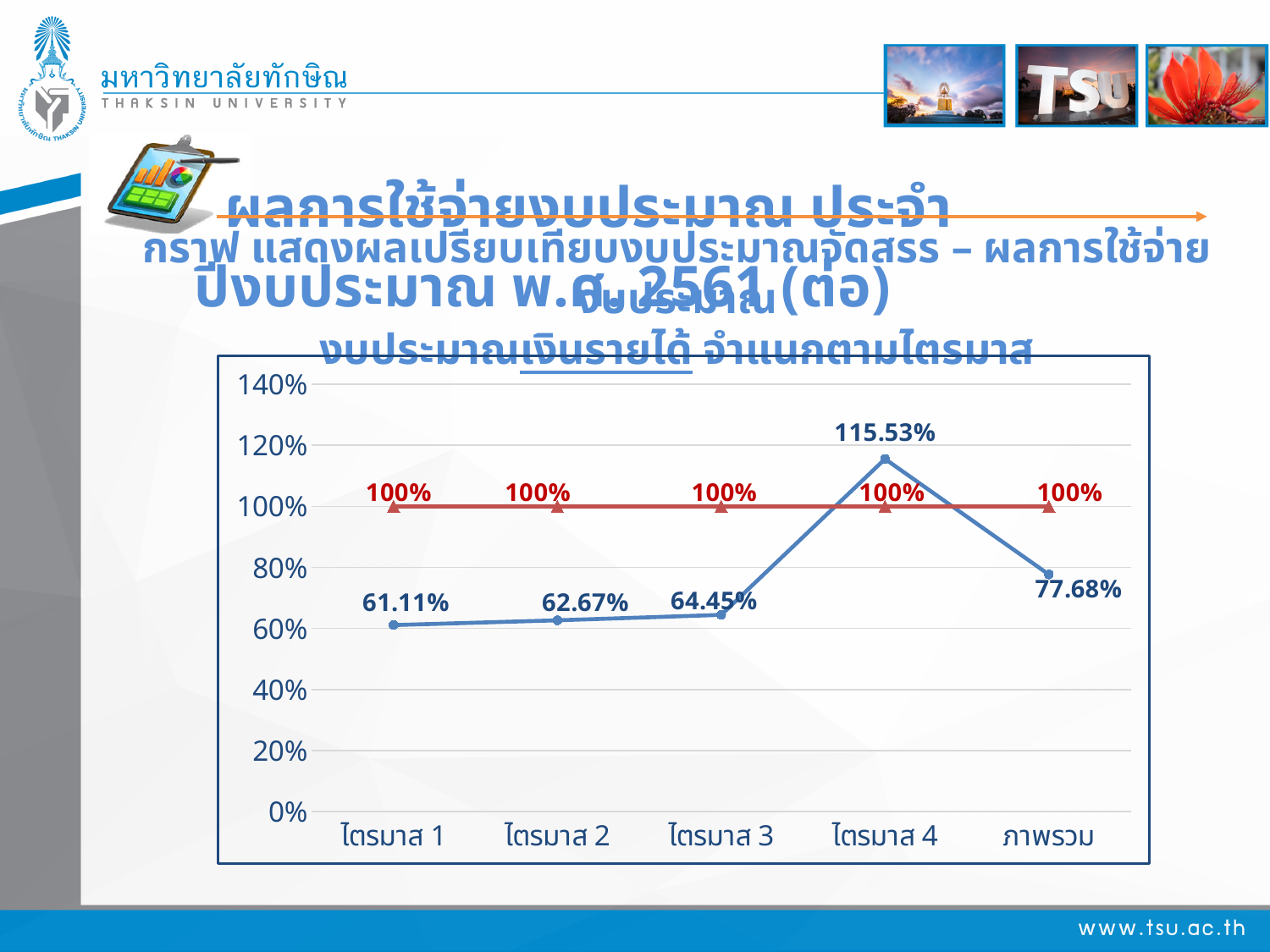
Which is larger, the blue line value for ไตรมาส 2 or for ไตรมาส 3? ไตรมาส 3 How many categories are shown on the x axis? 5 What is the title of the chart? งบประมาณเงินรายได้ จำแนกตามไตรมาส Which category has the highest value on the blue line? ไตรมาส 4 What is the value of the red line for ไตรมาส 3? 100% What is the value of the blue line for ไตรมาส 4? 115.53% Does the blue line rise or fall from ไตรมาส 1 to ไตรมาส 3? rise What is the difference between the blue line values for ไตรมาส 4 and ไตรมาส 1? 54.42% What type of chart is shown on the slide? line chart Which category has the lowest value on the blue line? ไตรมาส 1 What is the value of the blue line for ไตรมาส 1? 61.11% What is the value of the blue line for ภาพรวม? 77.68%